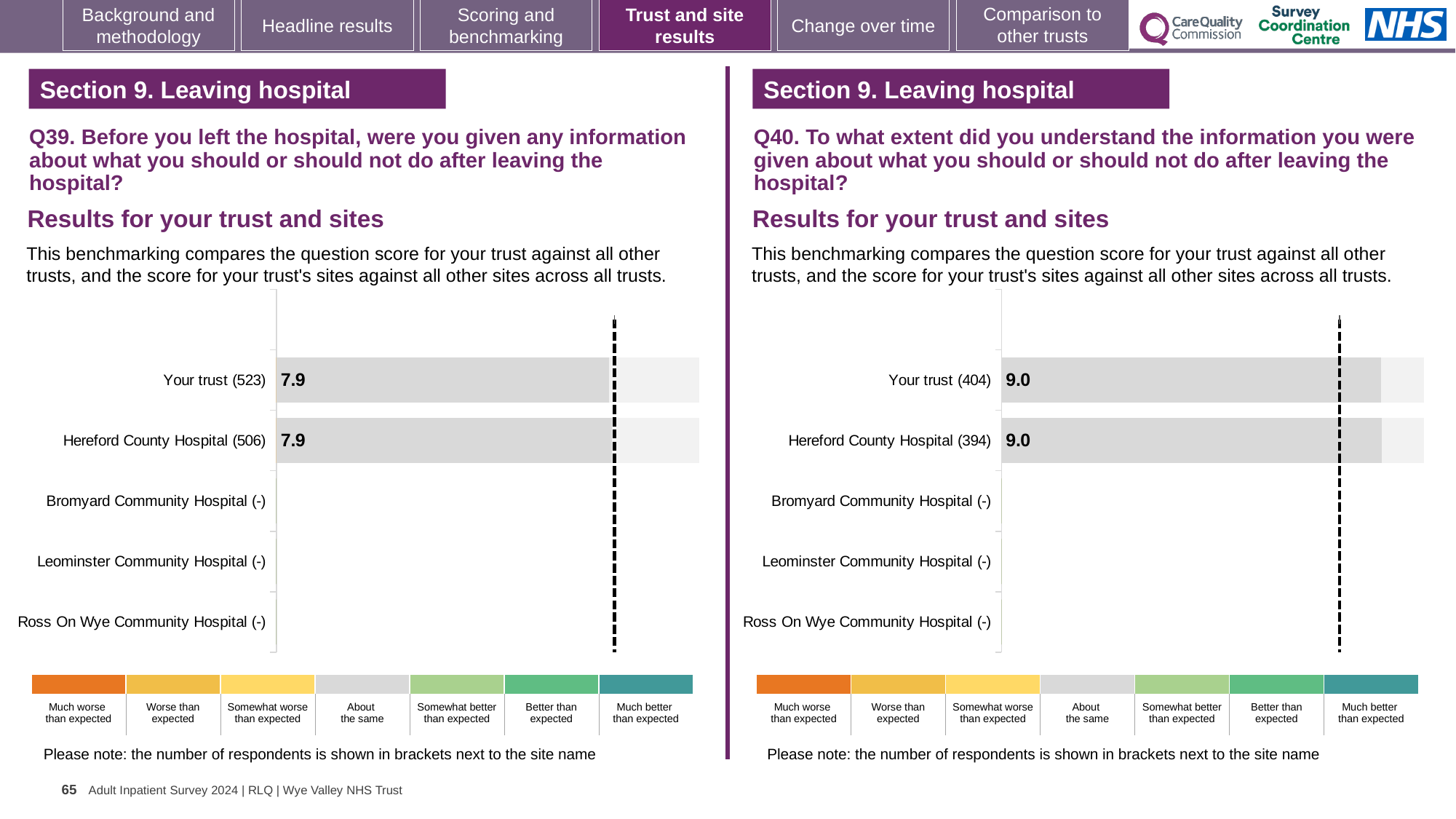
On the Q40 chart (right), what is the score for Hereford County Hospital? 9.0 On the Q40 chart (right), how many respondents are shown in brackets for Hereford County Hospital? 394 On the Q40 chart (right), how many sites or categories are listed on the vertical axis? 5 What kind of chart is the Q39 chart (left)? Bar chart Is the score for Your trust on the Q40 chart (right) larger or smaller than the score for Your trust on the Q39 chart (left)? Larger On the Q39 chart (left), what is the score for Your trust? 7.9 On the Q39 chart (left), what is the difference between the scores for Your trust and Hereford County Hospital? 0.0 On the Q39 chart (left), how many respondents are shown in brackets for Your trust? 523 On the Q39 chart (left), what is the score for Hereford County Hospital? 7.9 On the Q40 chart (right), what is the score for Your trust? 9.0 On the Q40 chart (right), what is the difference between the scores for Your trust and Hereford County Hospital? 0.0 On the Q39 chart (left), how many sites or categories are listed on the vertical axis? 5